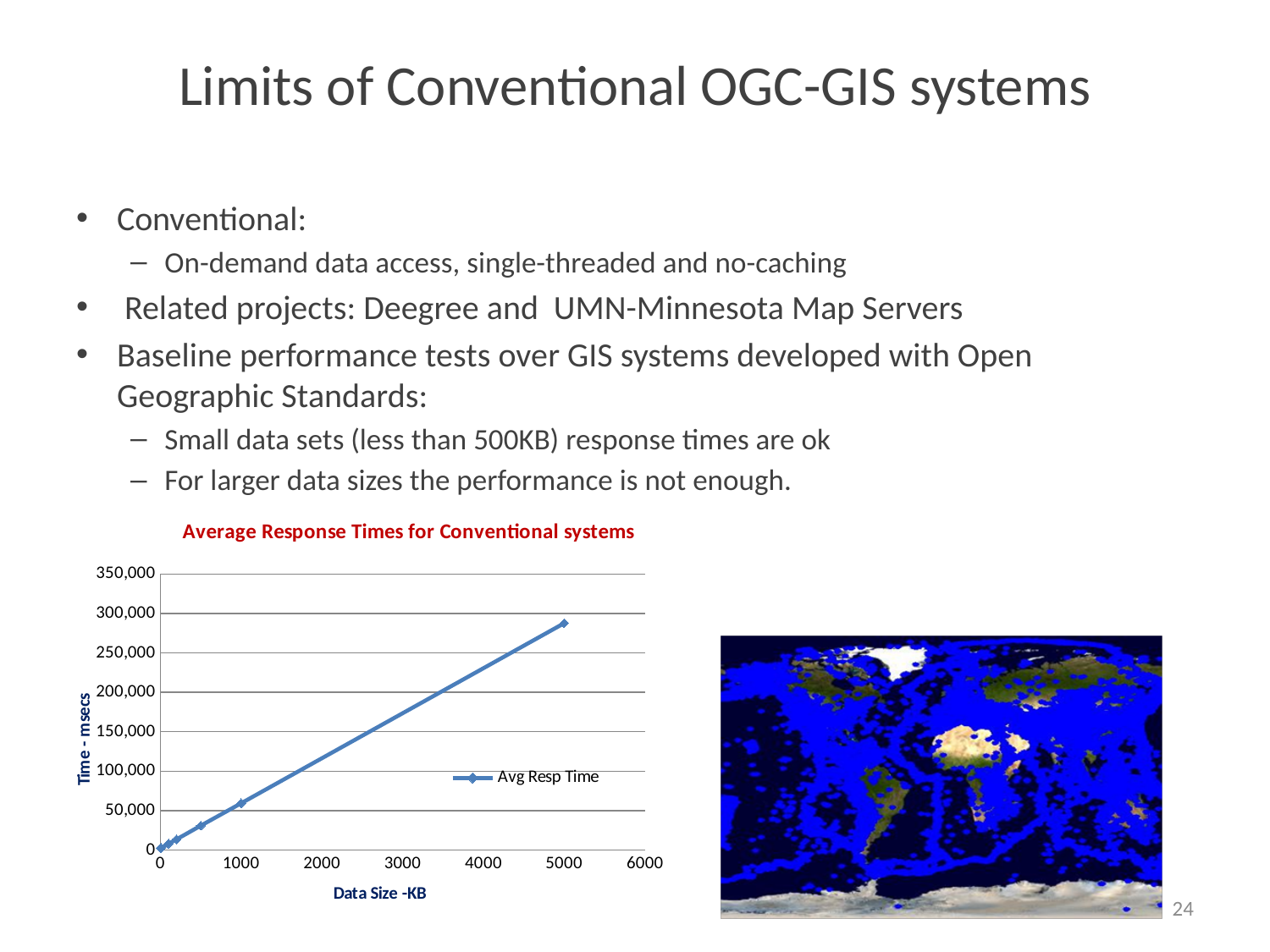
Does the average response time rise or fall as data size increases along the x axis? rise Which is larger, the average response time at 1000 KB or at 5000 KB? 5000 KB Is the average response time at a data size of 5000 KB greater or less than 250,000 msecs? greater What is the title of the chart? Average Response Times for Conventional systems How many series does the chart legend list? 1 What kind of chart is shown on the slide? line chart Is the average response time at a data size of 5000 KB greater or less than 300,000 msecs? less Is the average response time at a data size of 1000 KB greater or less than 100,000 msecs? less What is the name of the series shown in the chart legend? Avg Resp Time Which data size has the highest average response time in the chart? 5000